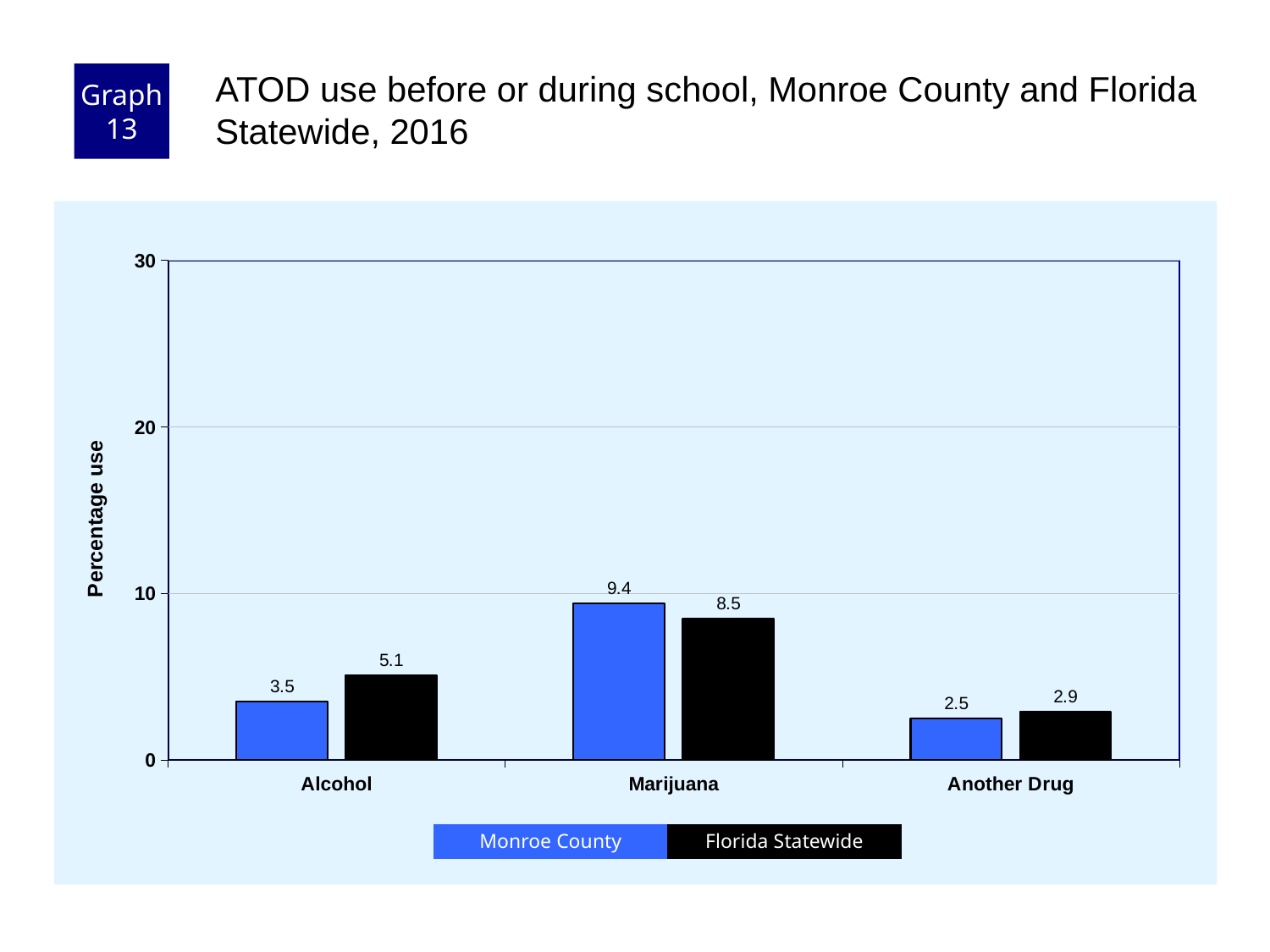
How many categories are shown on the x axis? 3 Which category has the highest Monroe County value? Marijuana What is the Monroe County value for Another Drug? 2.5 How many series does the legend list? 2 What kind of chart is shown? bar chart What is the label of the y axis? Percentage use Which is larger for Marijuana, Monroe County or Florida Statewide? Monroe County What is the Monroe County value for Marijuana? 9.4 What is the difference between the Florida Statewide and Monroe County values for Alcohol? 1.6 Is the Florida Statewide value for Marijuana greater or less than 10? less Which category has the lowest Florida Statewide value? Another Drug What is the Florida Statewide value for Alcohol? 5.1